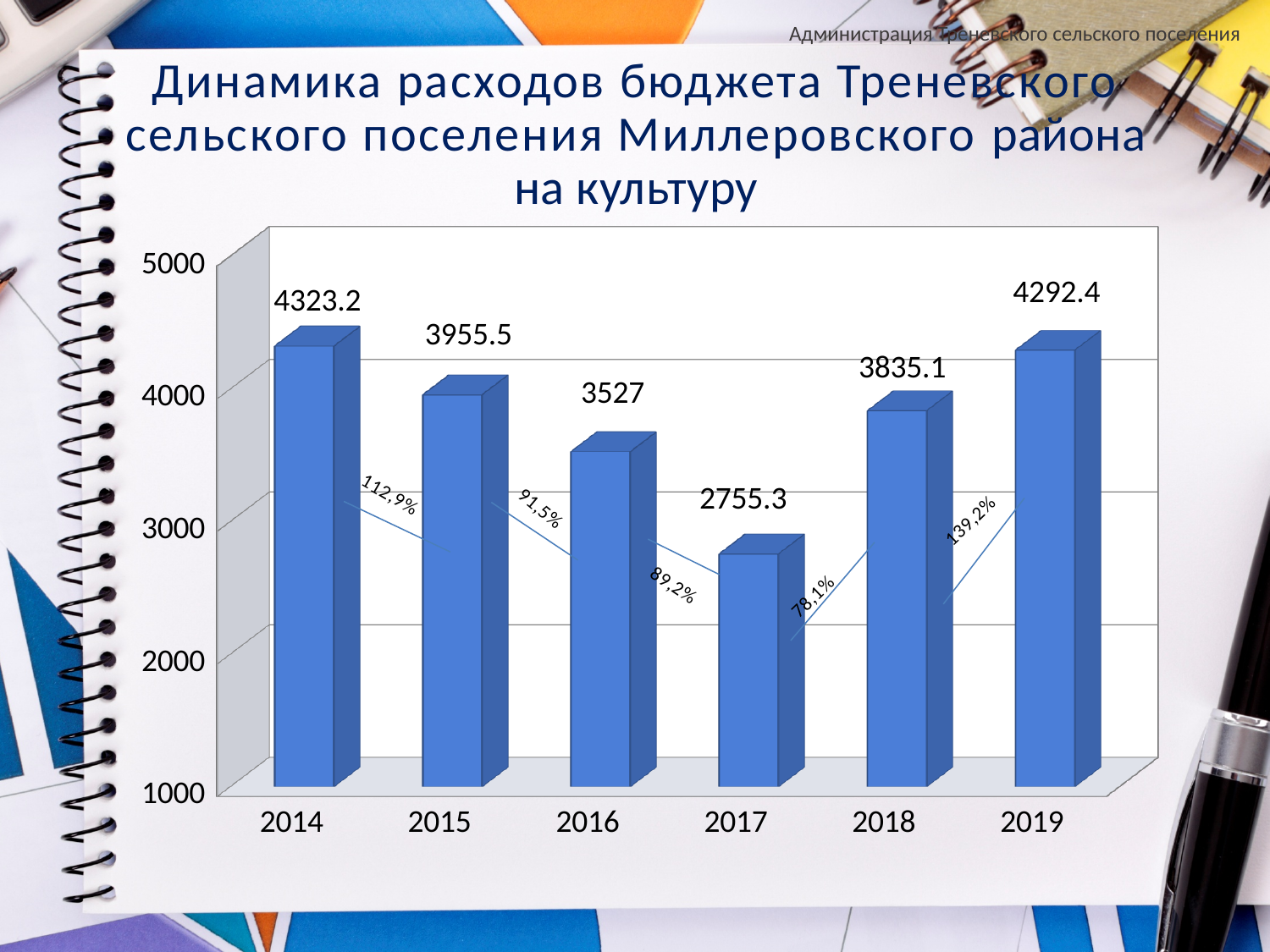
What kind of chart is shown on the slide? Bar chart What is the value for 2016? 3527 What percentage label is shown between the 2018 and 2019 bars? 139,2% What is the value for 2017? 2755.3 What is the difference between the values for 2018 and 2017? 1079.8 Which year has the lowest value? 2017 Which is larger, the value for 2015 or the value for 2018? 2015 What is the value for 2019? 4292.4 What is the difference between the values for 2015 and 2016? 428.5 What is the value for 2014? 4323.2 How many years are shown on the x axis? 6 Which year has the highest value? 2014